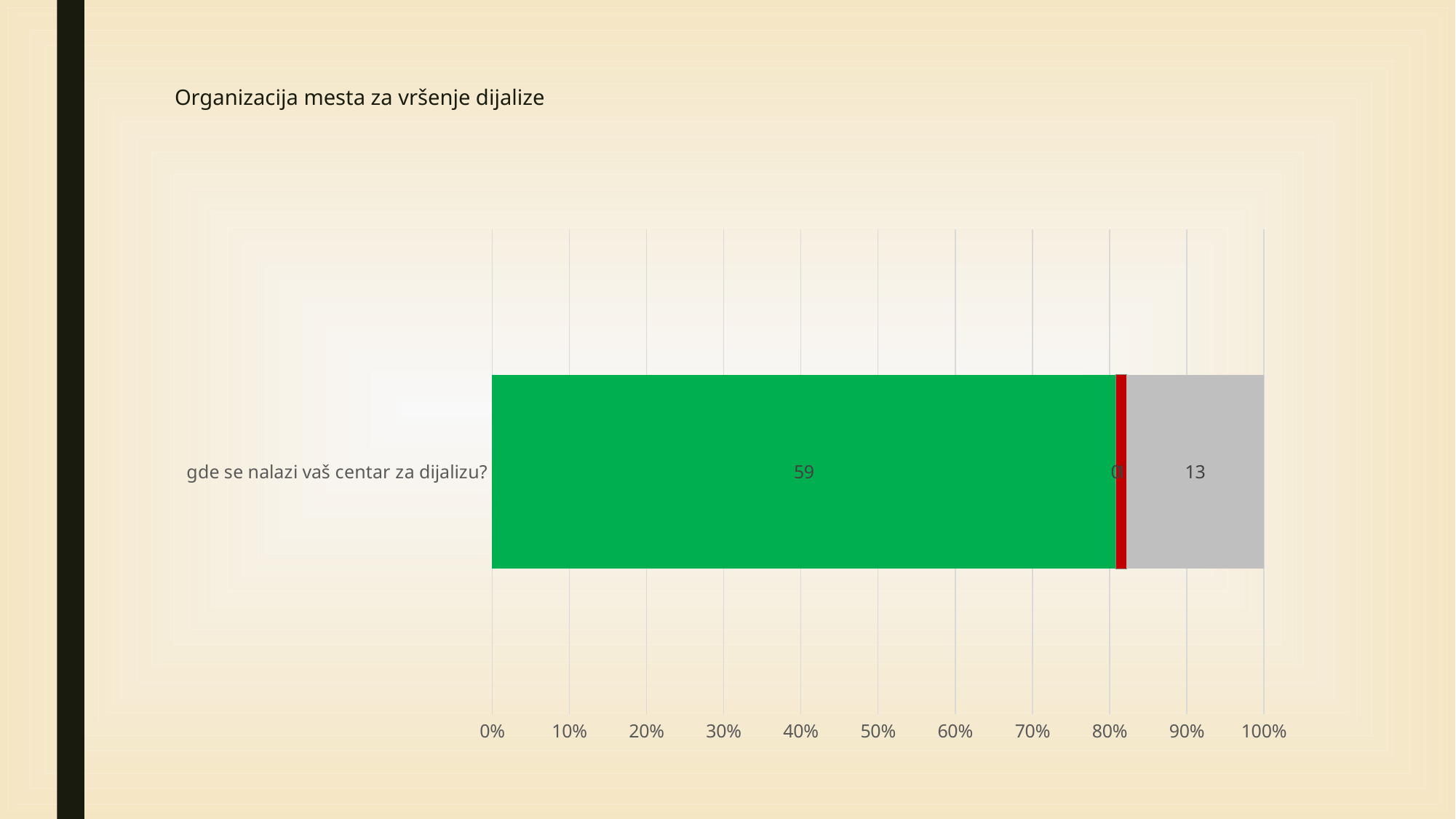
How many categories are plotted on the chart? 1 Which segment of the bar has the smallest value? the red segment Does the green segment of the bar extend to greater or less than 70% on the axis? greater Which is larger, the green segment value or the grey segment value? the green segment (59) What value is printed on the green segment of the bar? 59 What kind of chart is shown on the slide? bar chart How many segments make up the bar? 3 What is the category label shown on the chart? gde se nalazi vaš centar za dijalizu? What value is printed on the grey segment of the bar? 13 What is the title of the chart? Organizacija mesta za vršenje dijalize What is the difference between the green segment value (59) and the grey segment value (13)? 46 Which segment of the bar has the largest value? the green segment (59)